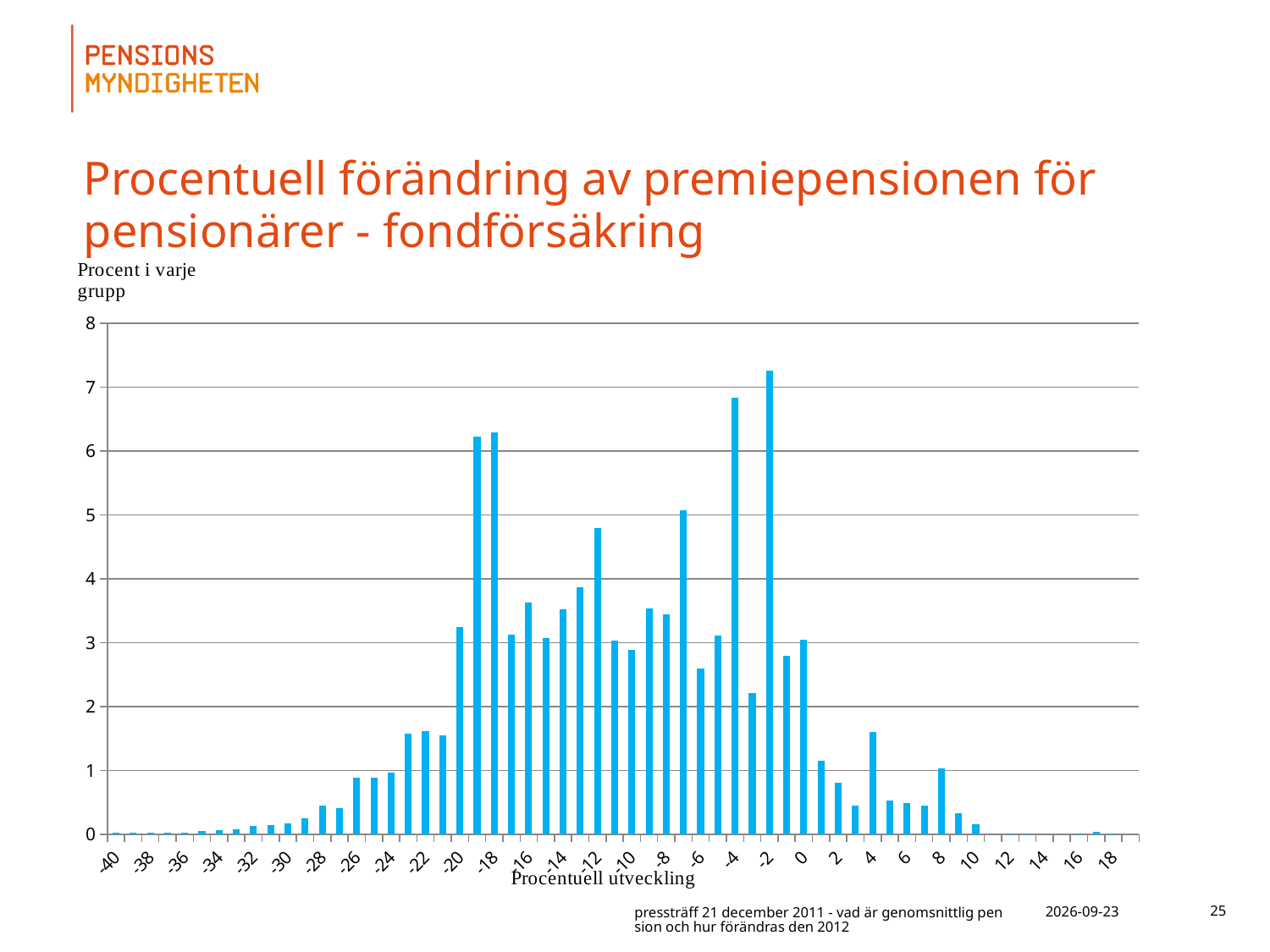
Is the value for -4 greater or less than 6? greater Do the values generally rise or fall along the x axis from -40 to -20? rise Which x-axis category has the highest bar? -2 What kind of chart is shown on the slide? bar chart Which has the larger value, -12 or -6? -12 Is the value for -26 greater or less than 1? less Is the value for -12 greater or less than 4? greater What is the label on the x axis of the chart? Procentuell utveckling Which has the larger value, -2 or -4? -2